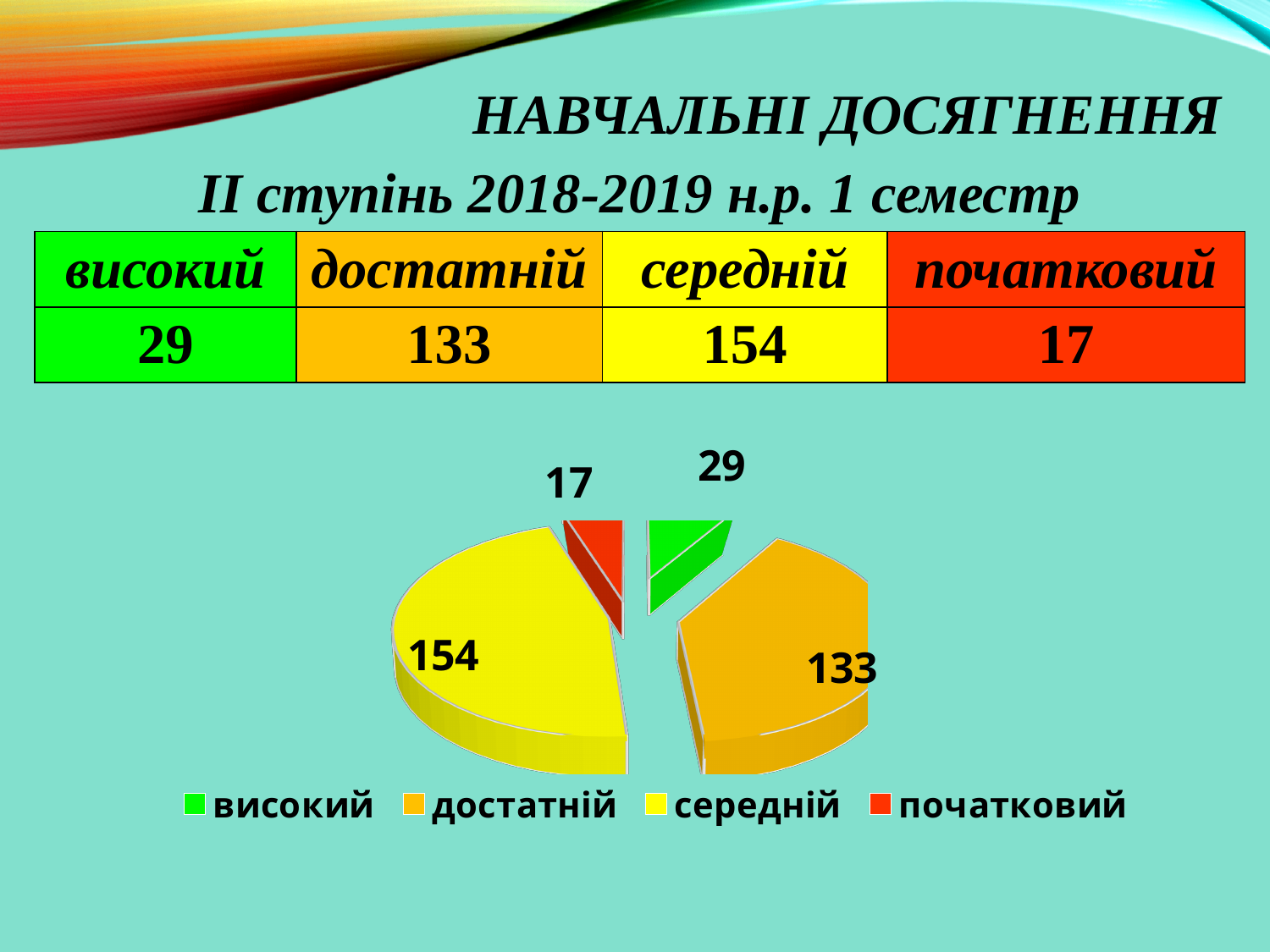
Which category has the largest slice in the pie chart? середній What value is shown for the "високий" slice of the pie chart? 29 What colour is the "середній" slice in the pie chart? yellow What value is shown for the "достатній" slice of the pie chart? 133 What is the total of all the values in the pie chart? 333 Which is larger in the pie chart, "високий" or "початковий"? високий How many slices does the pie chart have? 4 What is the difference between the values for "середній" and "достатній" in the pie chart? 21 What value is shown for the "середній" slice of the pie chart? 154 What type of chart is shown on the slide? pie chart What value is shown for the "початковий" slice of the pie chart? 17 Which category has the smallest slice in the pie chart? початковий